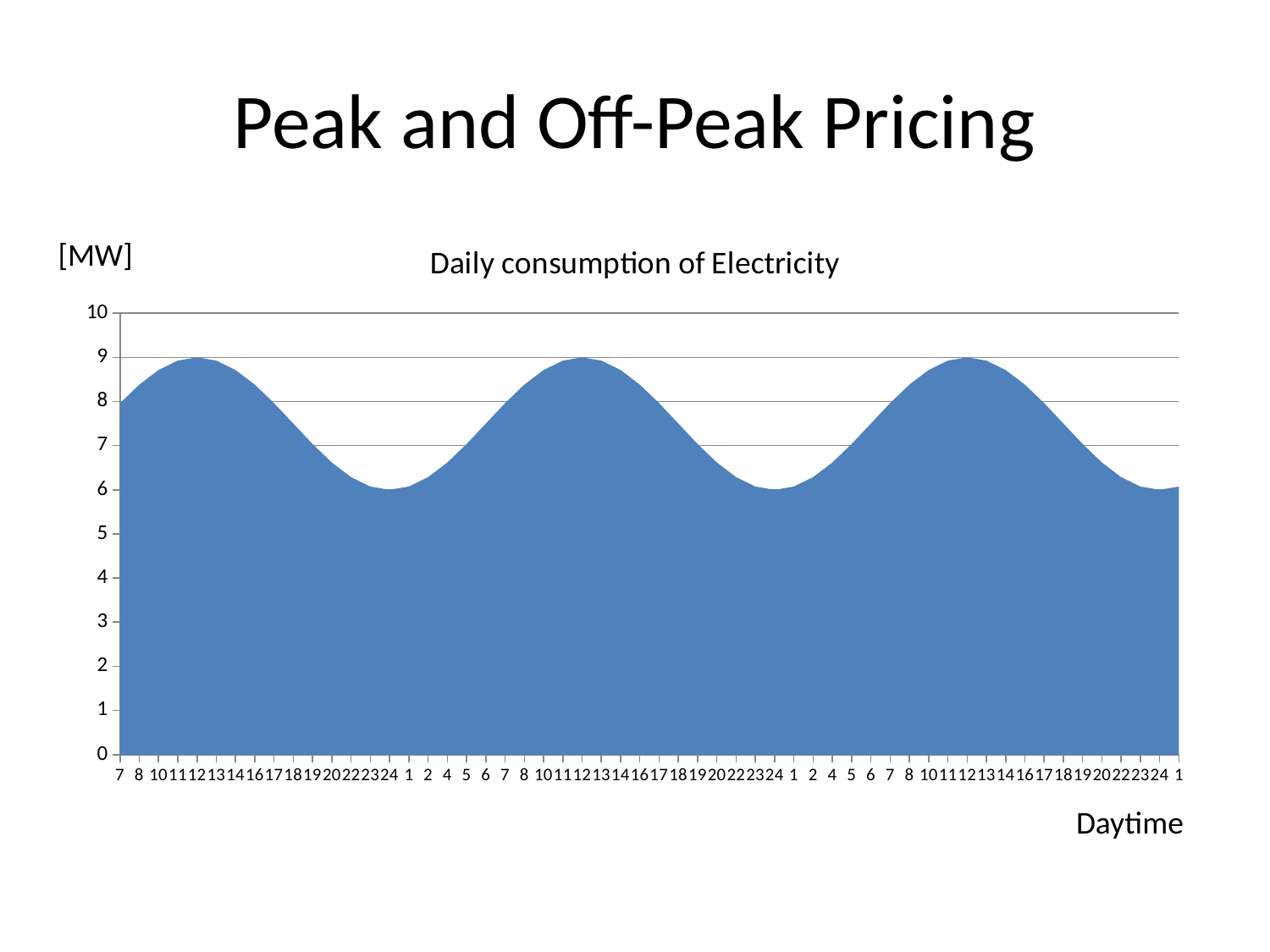
Is the value at the first peak (around 12) greater or less than 8? greater Is the value at the troughs greater or less than 5? greater Is the value at the first x-axis point (7) greater or less than 7? greater What is the title of the chart? Daily consumption of Electricity Do the values rise or fall from 7 to 12 at the start of the x axis? rise How many peaks does the consumption curve show across the x axis? 3 What kind of chart is shown on the slide? area chart What unit is shown for the vertical axis of the chart? [MW] Do the values rise or fall from 12 to 24 in the first cycle? fall